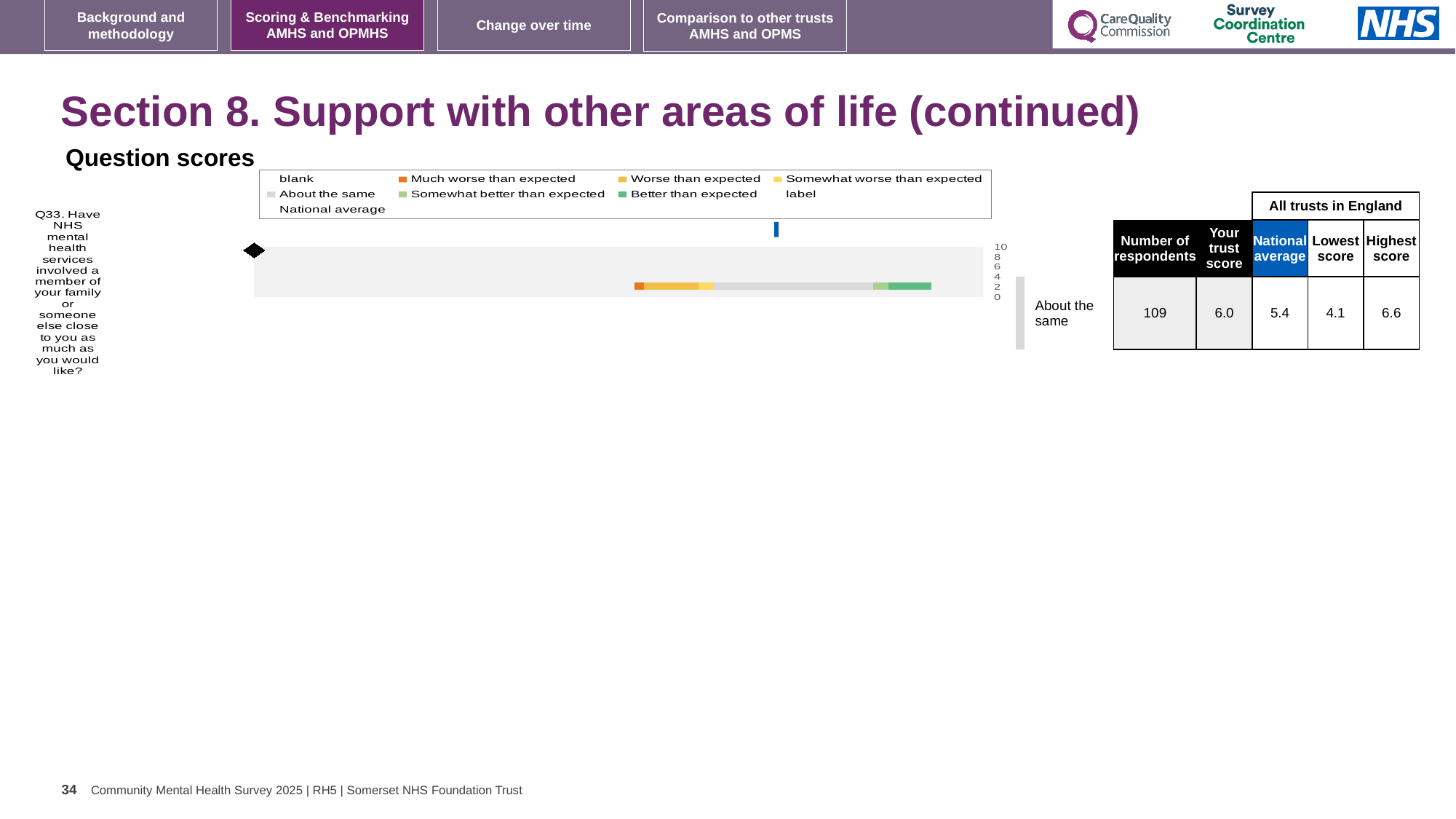
How many survey questions are plotted in the question scores chart? 1 How many respondents answered Q33? 109 What is the national average score for Q33? 5.4 What kind of chart is used to show the Q33 question score? bar chart What is the difference between the highest and lowest scores among all trusts in England for Q33? 2.5 Which is larger for Q33: the trust's score or the national average? the trust's score What is the highest score among all trusts in England for Q33? 6.6 What is the trust's score for Q33 shown in the table beside the chart? 6.0 In the chart legend, what colour represents 'Much worse than expected'? orange What is the difference between the trust's score and the national average for Q33? 0.6 What is the lowest score among all trusts in England for Q33? 4.1 Which question is plotted in the question scores chart? Q33. Have NHS mental health services involved a member of your family or someone else close to you as much as you would like?